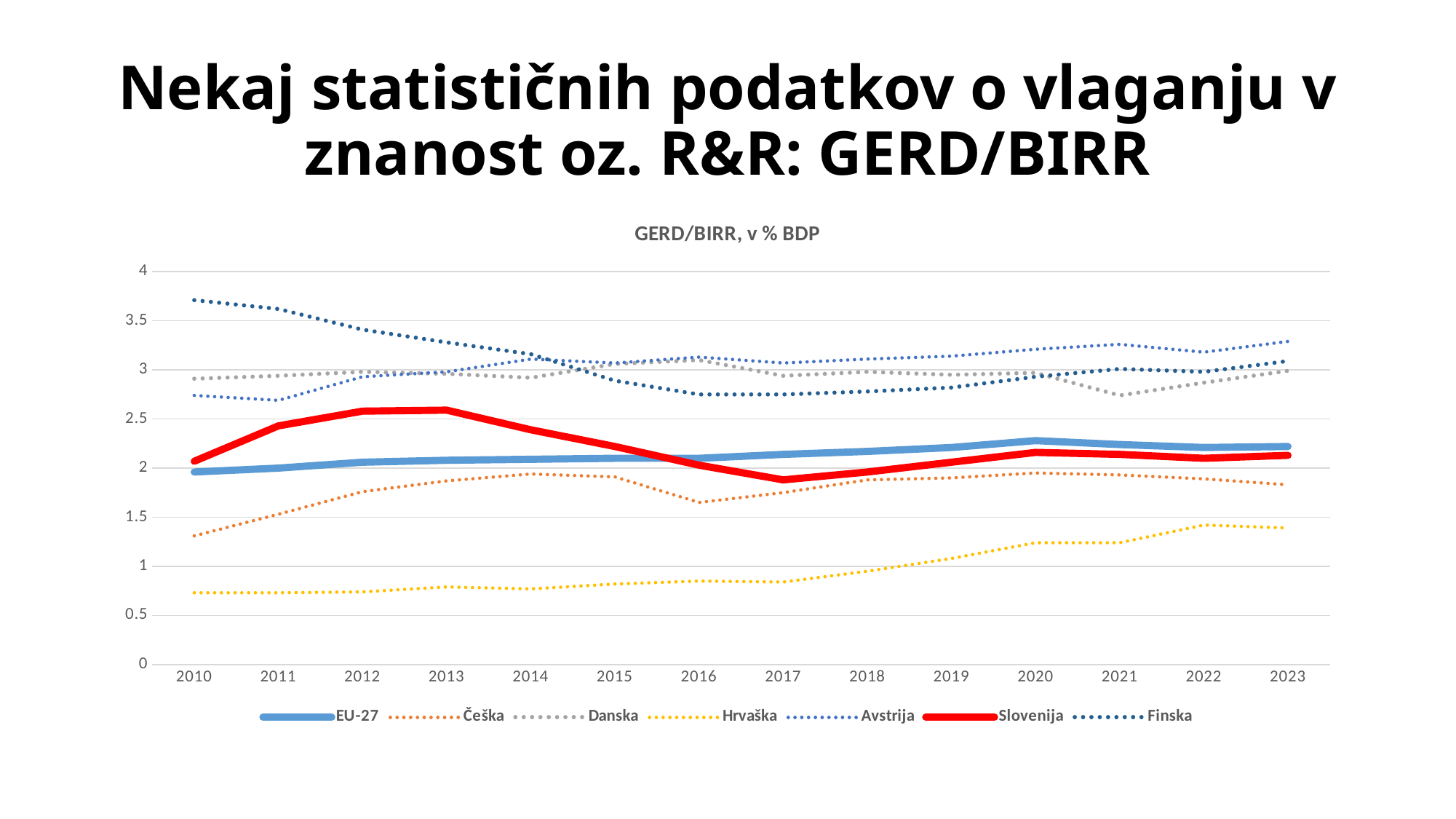
Which series has the lowest value in 2023? Hrvaška How many series does the chart legend list? 7 Which series has the highest value in 2010? Finska Is the value for Finska in 2010 greater or less than 3.5? greater Which series has the lowest value in 2010? Hrvaška What kind of chart is shown on the slide? line chart Is the value for Hrvaška in 2010 greater or less than 1? less How many years are shown on the x axis of the chart? 14 Is the value for Slovenija in 2017 greater or less than 2? less Does the value for Finska rise or fall from 2010 to 2017? fall Which is larger in 2012, the value for Slovenija or the value for EU-27? Slovenija What is the title of the chart? GERD/BIRR, v % BDP